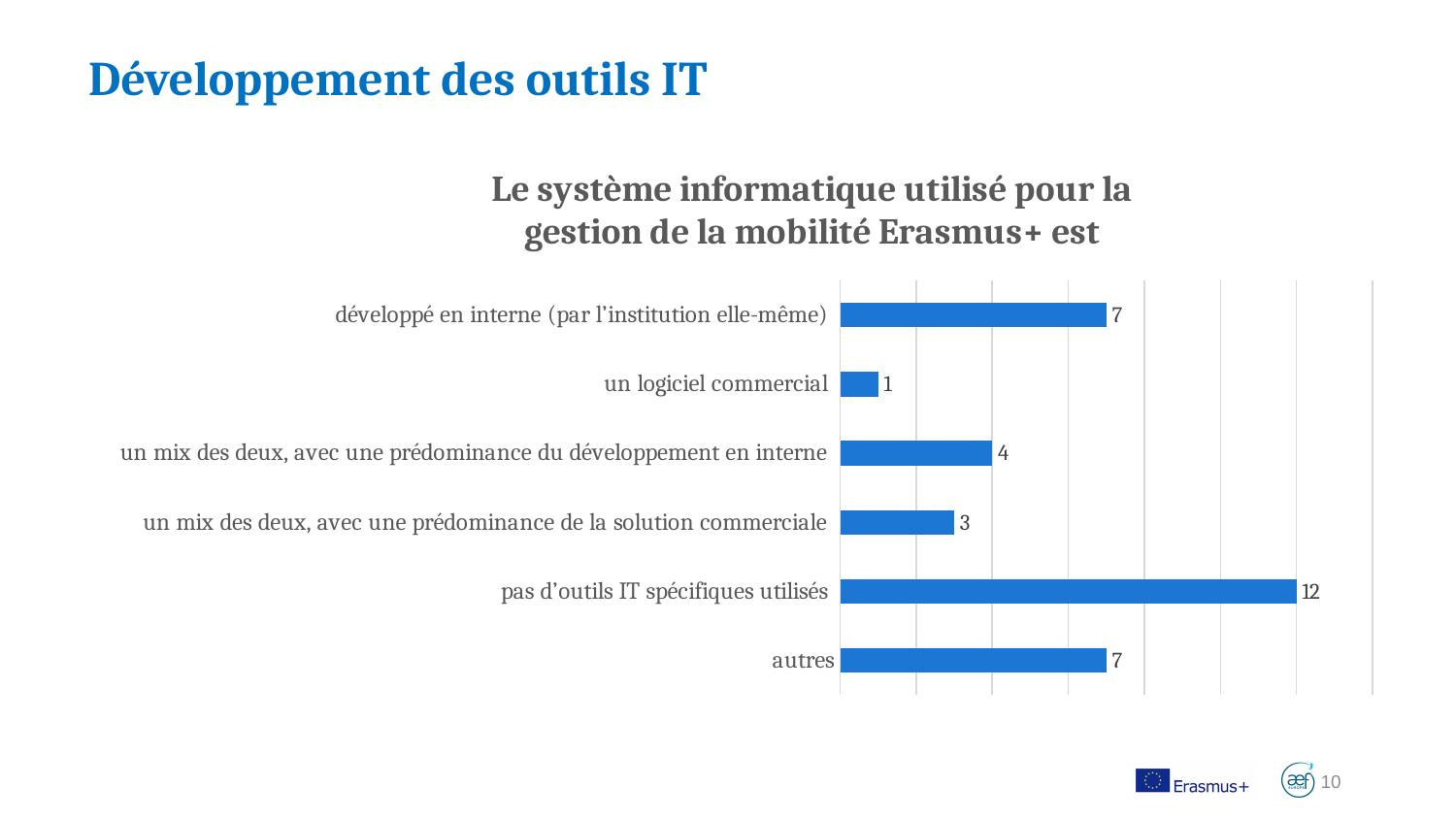
What value is shown for "pas d'outils IT spécifiques utilisés"? 12 Which is larger: the value for "un mix des deux, avec une prédominance du développement en interne" or the value for "un mix des deux, avec une prédominance de la solution commerciale"? un mix des deux, avec une prédominance du développement en interne What value is shown for "développé en interne (par l'institution elle-même)"? 7 How many categories are shown in the chart? 6 What is the title of the chart? Le système informatique utilisé pour la gestion de la mobilité Erasmus+ est What value is shown for "un logiciel commercial"? 1 Which category has the lowest value? un logiciel commercial What kind of chart is shown on the slide? bar chart What is the difference between the value for "pas d'outils IT spécifiques utilisés" and the value for "autres"? 5 Which category has the highest value? pas d'outils IT spécifiques utilisés What value is shown for "un mix des deux, avec une prédominance du développement en interne"? 4 What value is shown for "un mix des deux, avec une prédominance de la solution commerciale"? 3